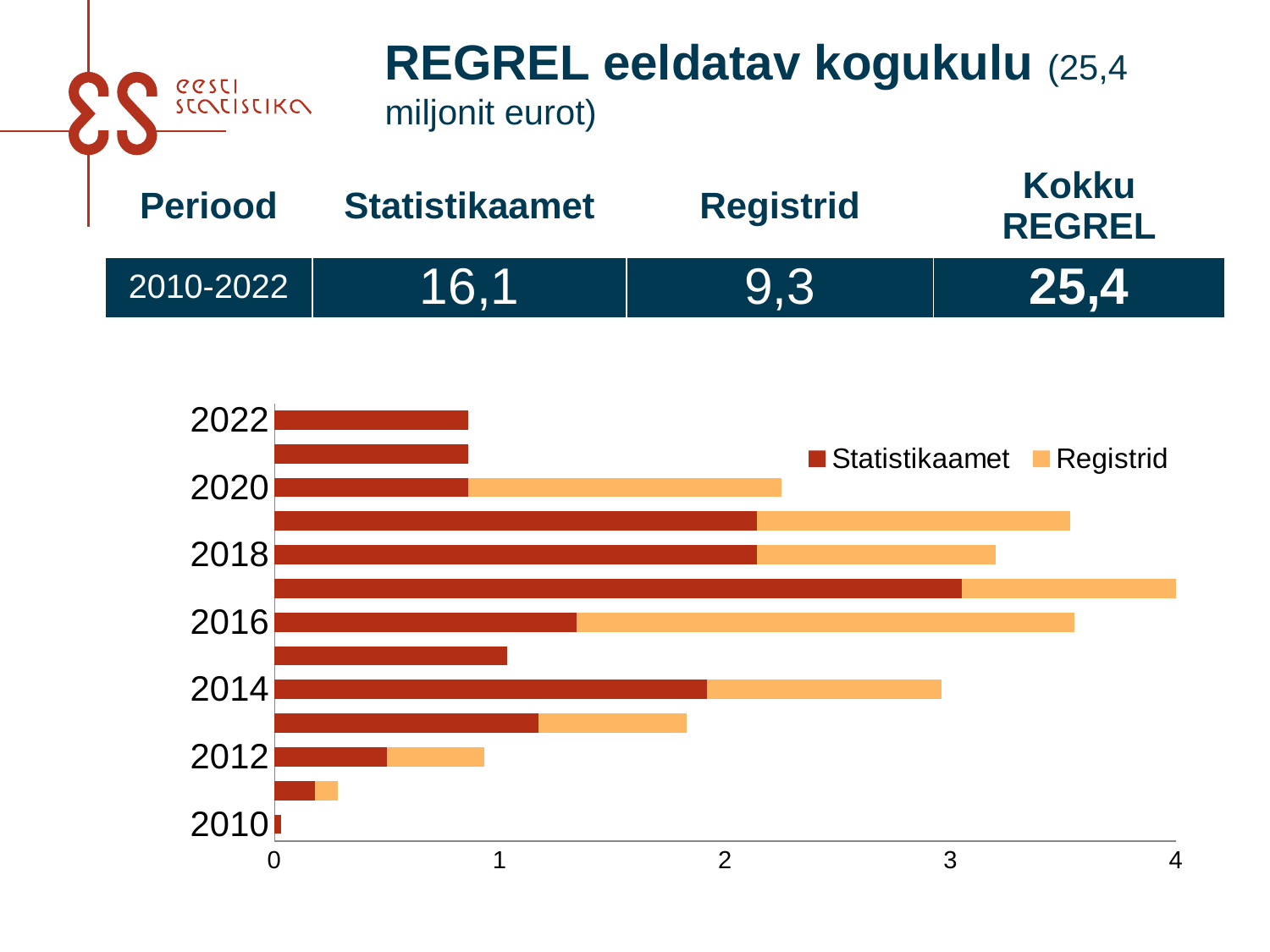
Is the total bar length for 2016 greater or less than 3? greater Which year has the longer total bar, 2016 or 2018? 2016 Which year has the shortest bar in the chart? 2010 Is the total bar length for 2012 greater or less than 1? less Which two series are listed in the chart legend? Statistikaamet and Registrid What kind of chart is shown on the slide? bar chart How many bars (years) are plotted in the chart? 13 Which colour represents the Registrid series in the chart? orange Is the total bar length for 2020 greater or less than 2? greater Which year has the longer total bar, 2020 or 2022? 2020 How many series does the chart legend list? 2